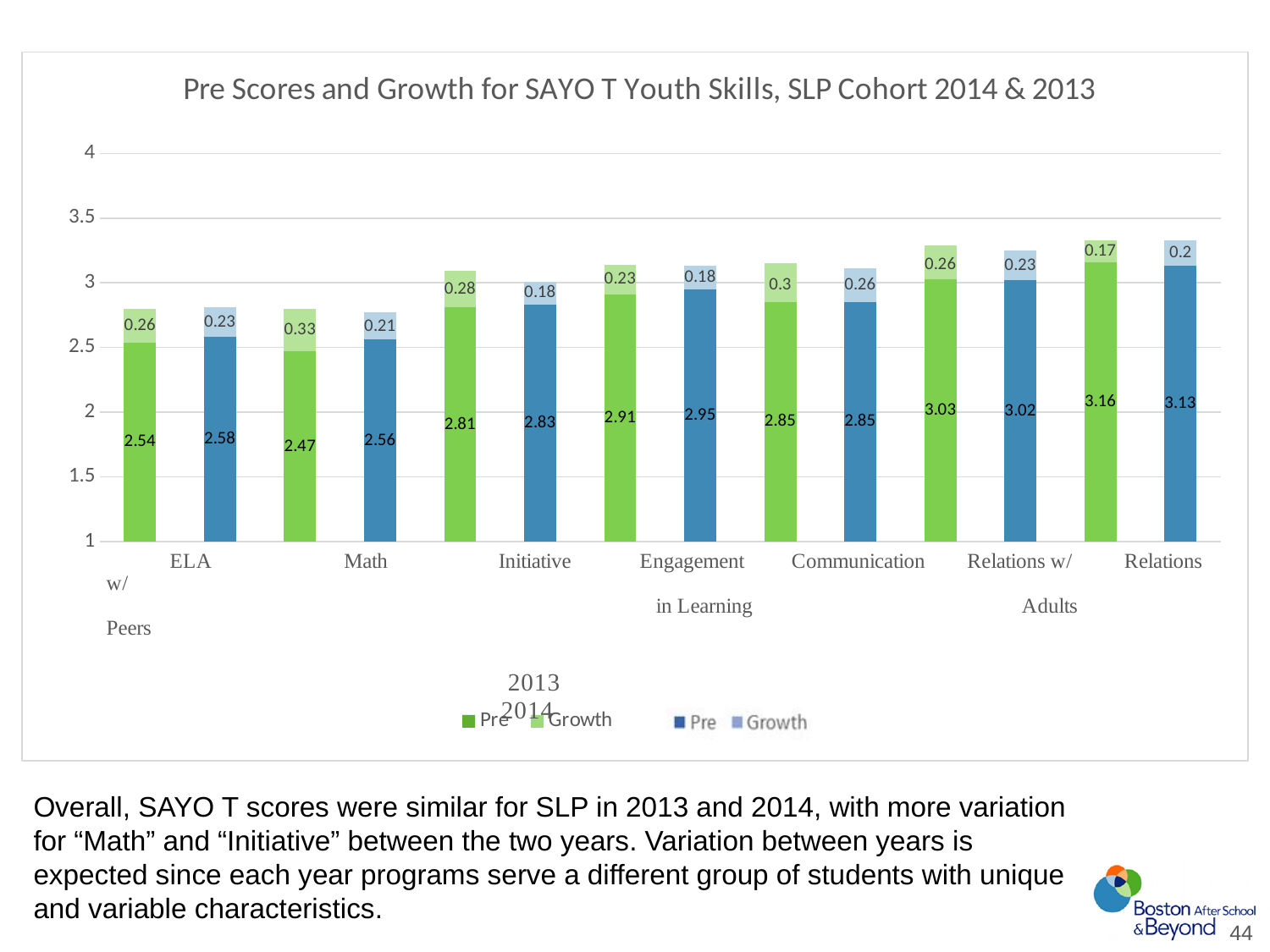
What is the 2014 Growth value for Communication? 0.26 What kind of chart is shown on the slide? Stacked bar chart What is the 2013 Pre score for Math? 2.47 What is the difference between the 2014 Pre score and the 2013 Pre score for Math? 0.09 What is the title of the chart? Pre Scores and Growth for SAYO T Youth Skills, SLP Cohort 2014 & 2013 Is the 2013 Growth value for Math larger or smaller than the 2014 Growth value for Math? larger How many series does the legend list? 4 Which category has the highest 2013 Pre score? Relations w/ Peers What is the total of the 2013 Pre and Growth values for Engagement in Learning? 3.14 What is the 2013 Growth value for Initiative? 0.28 Which category has the largest 2013 Growth value? Math Which category has the lowest 2014 Pre score? Math